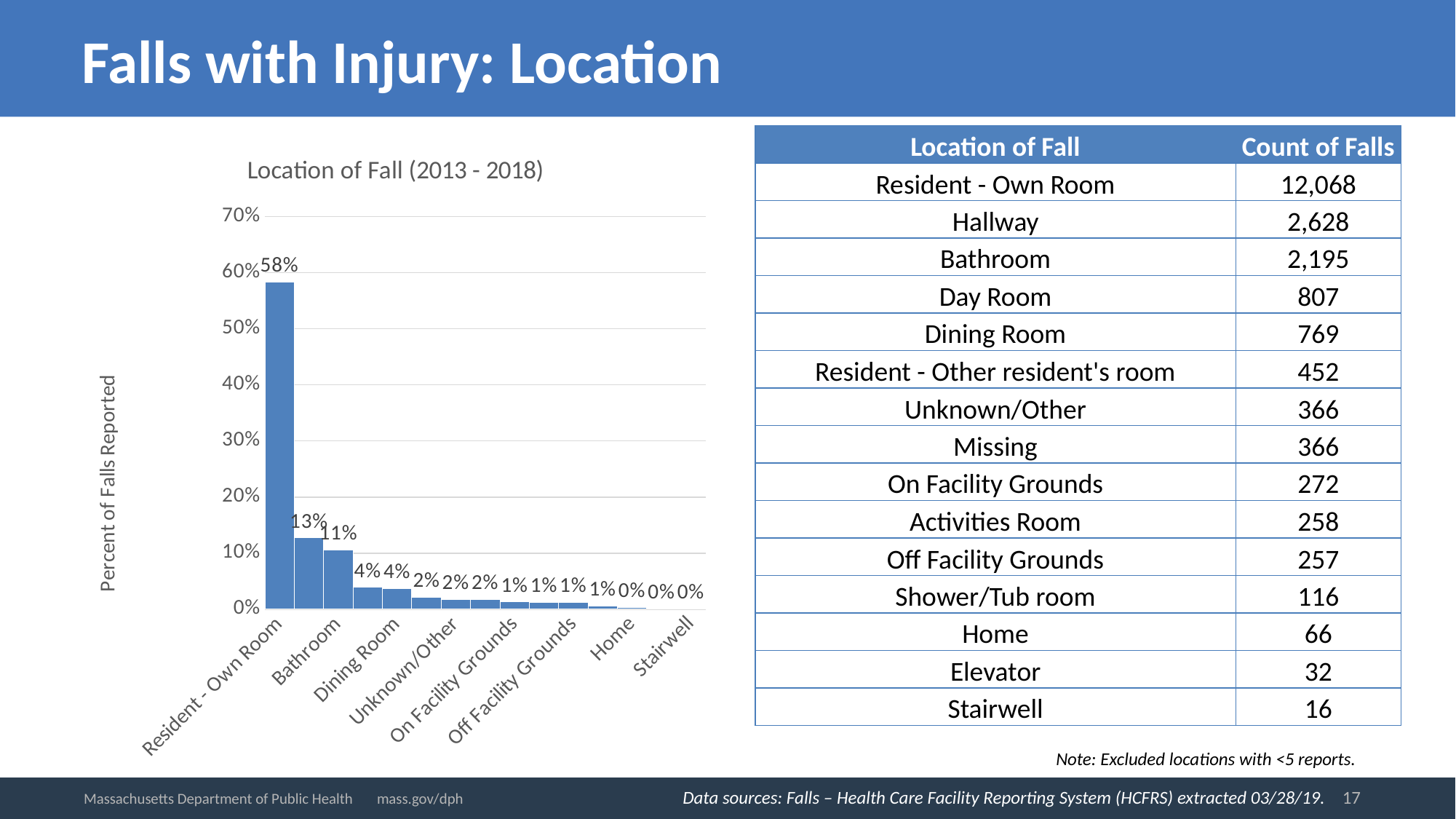
What percent of falls reported occurred in the Dining Room? 4% What kind of chart is shown on the slide? bar chart How many bars are plotted in the chart? 15 What is the title of the chart? Location of Fall (2013 - 2018) Which has a higher percent of falls reported, Bathroom or Dining Room? Bathroom What is the label on the vertical axis of the chart? Percent of Falls Reported Do the values rise or fall moving from left to right along the x axis? fall What percent of falls reported occurred in Resident - Own Room? 58% What percent of falls reported is shown for Unknown/Other? 2% Which location has the highest percent of falls reported? Resident - Own Room What percent of falls reported occurred in the Bathroom? 11% What is the difference in percent of falls reported between Resident - Own Room and Bathroom? 47%